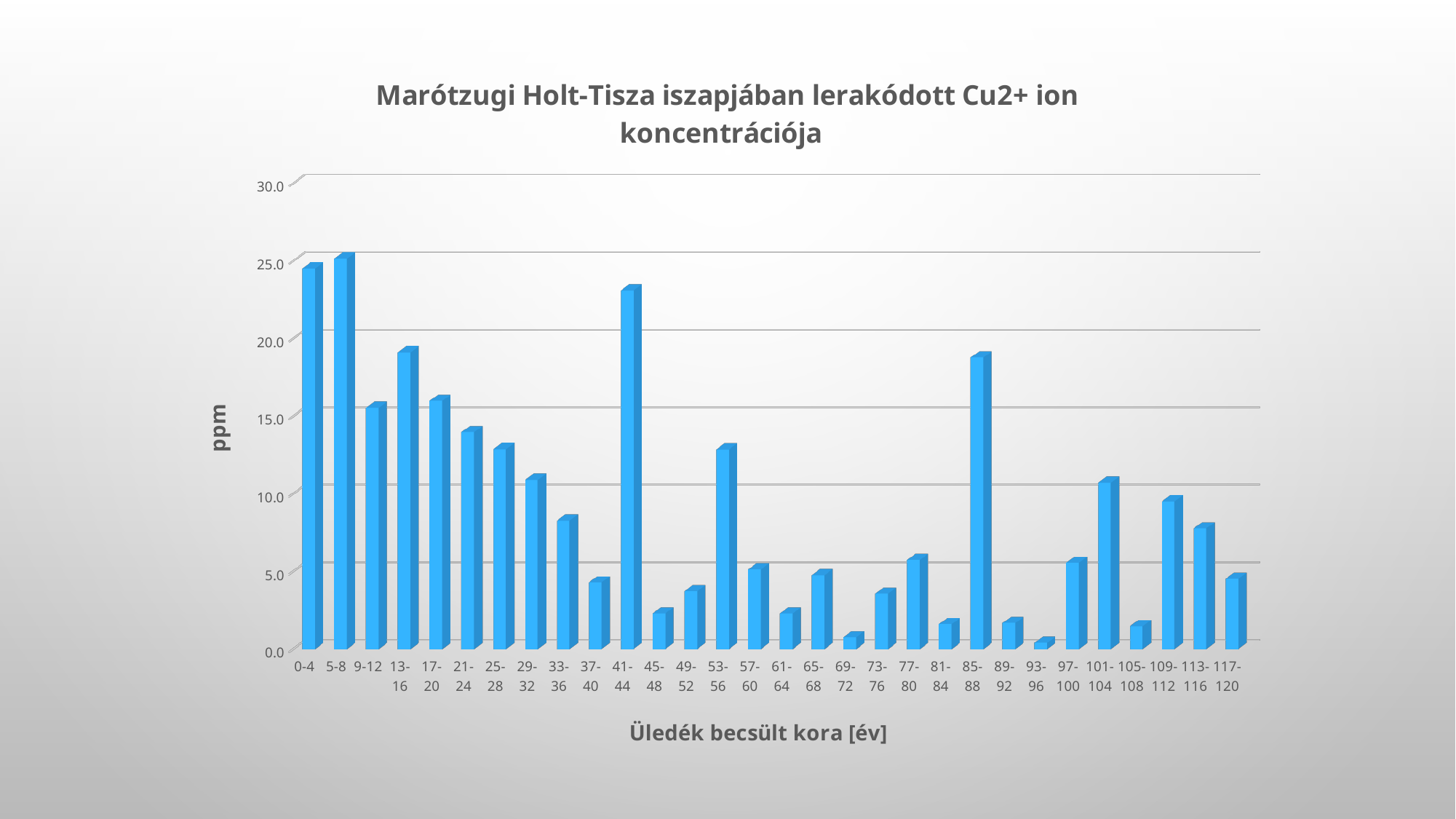
Do the values generally rise or fall from the 5-8 category to the 37-40 category? fall Is the value for the 33-36 category greater or less than 10? less Which sediment age category has the lowest Cu2+ concentration? 93-96 Is the value for the 41-44 category greater or less than 20? greater What kind of chart is shown on the slide? bar chart Is the value for the 0-4 category greater or less than 20? greater Which sediment age category has the highest Cu2+ concentration? 5-8 How many age categories are plotted along the x axis? 30 What is the label on the vertical axis? ppm Which has the larger value, the 13-16 category or the 17-20 category? 13-16